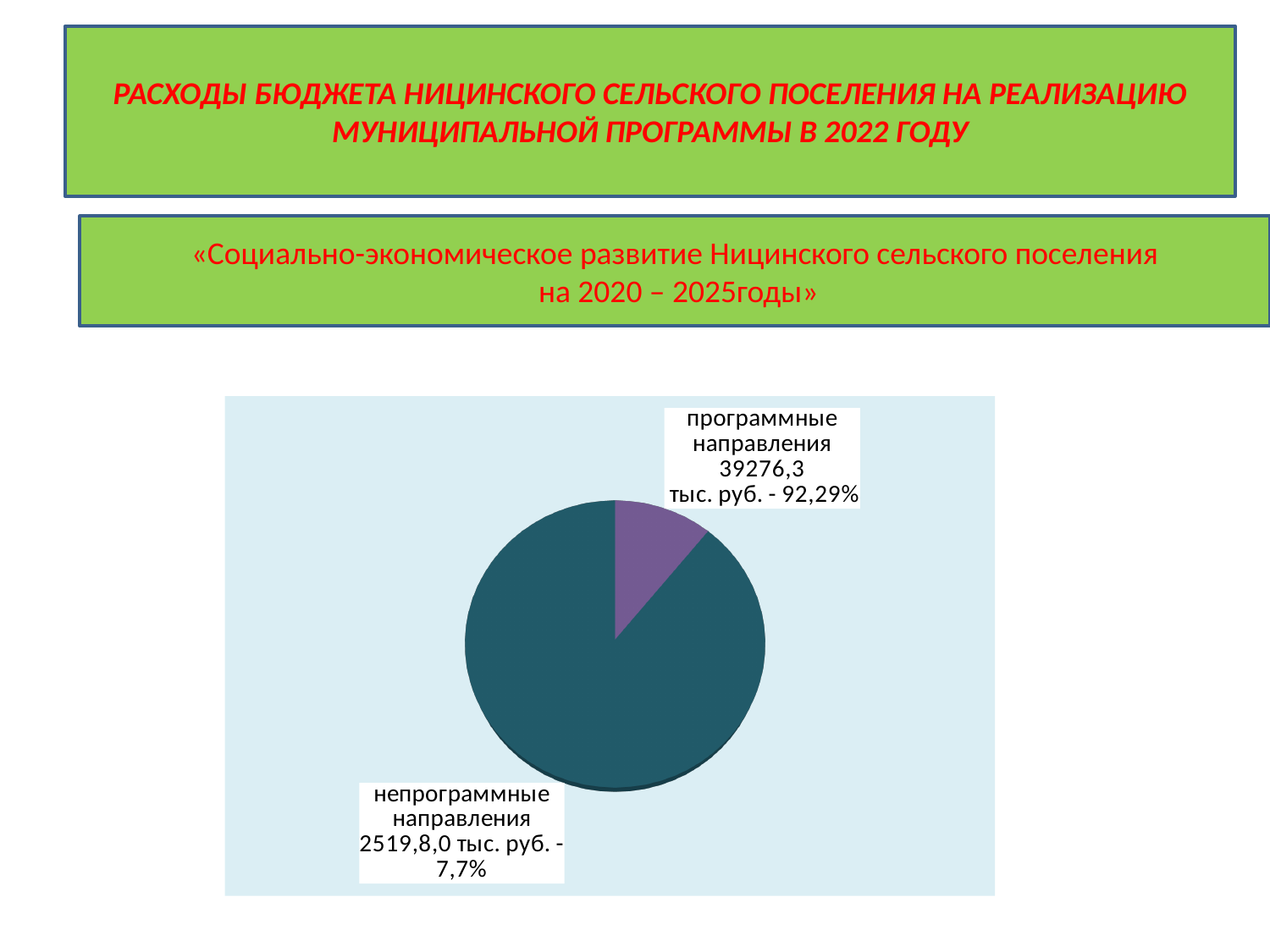
According to the slide title, which year do the budget expenditures in the chart refer to? 2022 What amount in тыс. руб. is labelled for программные направления? 39276,3 тыс. руб. What kind of chart is shown on the slide? pie chart How many slices does the pie chart have? 2 What period does the municipal programme named on the slide cover? 2020 – 2025 What share of the pie is labelled for непрограммные направления? 7,7% What is the difference in percentage points between the share for программные направления and the share for непрограммные направления? 84,59% What share of the pie is labelled for программные направления? 92,29%